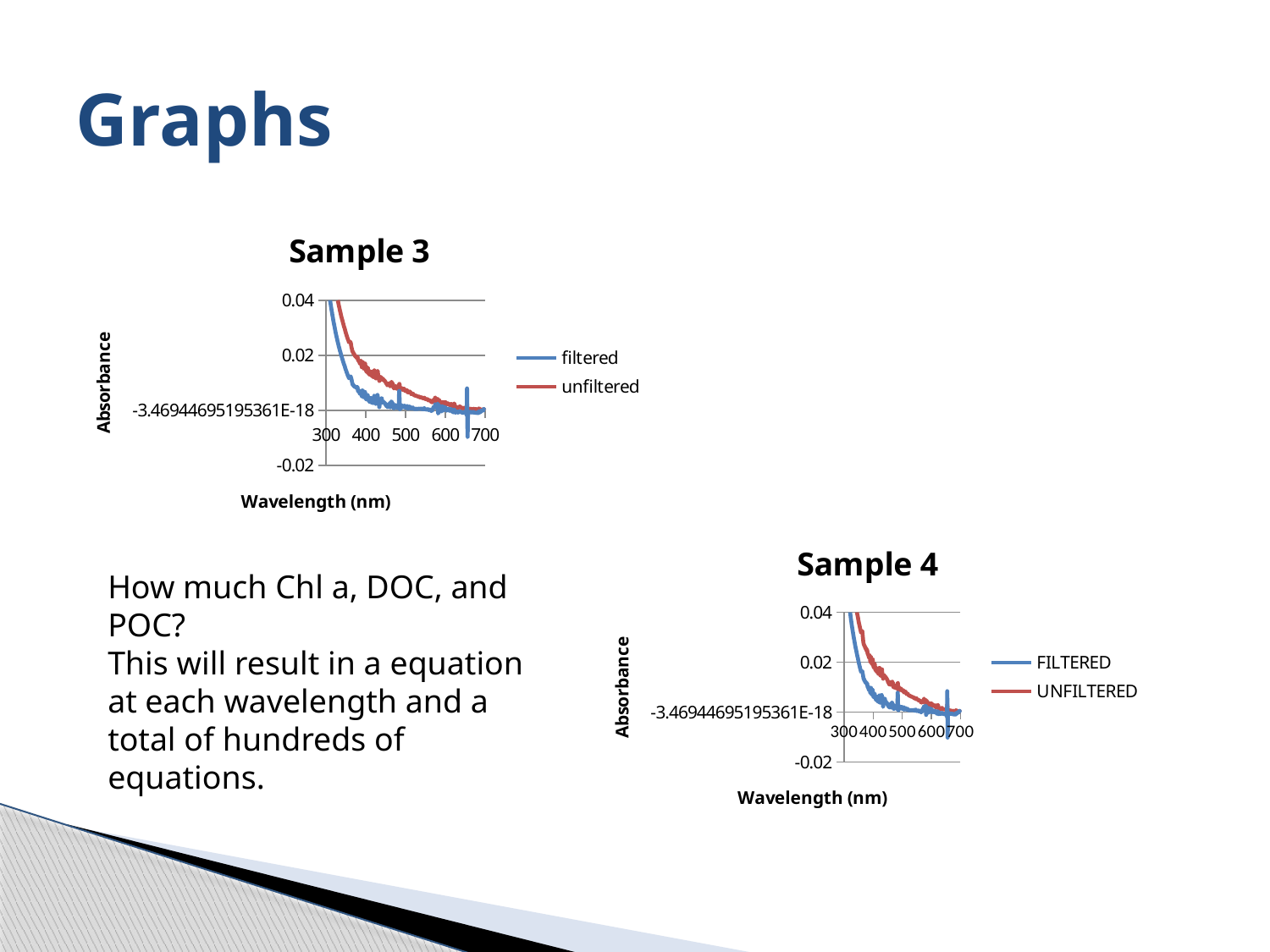
In the "Sample 4" chart, is the absorbance of the FILTERED series at 400 nm greater or less than 0.02? less In the "Sample 3" chart, is the absorbance of the unfiltered series at 500 nm greater or less than 0.02? less What kind of chart is the "Sample 3" chart? line chart How many series does the legend of the "Sample 4" chart list? 2 In the "Sample 3" chart, do the absorbance values rise or fall as wavelength increases from 300 nm to 700 nm? fall What colour is the UNFILTERED series line in the "Sample 4" chart? red In the "Sample 3" chart, which series has the higher absorbance at 400 nm, filtered or unfiltered? unfiltered How many series does the legend of the "Sample 3" chart list? 2 What is the x-axis title of the "Sample 3" chart? Wavelength (nm) What kind of chart is the "Sample 4" chart? line chart In the "Sample 4" chart, which series has the higher absorbance at 400 nm, FILTERED or UNFILTERED? UNFILTERED In the "Sample 4" chart, do the absorbance values rise or fall as wavelength increases from 300 nm to 700 nm? fall